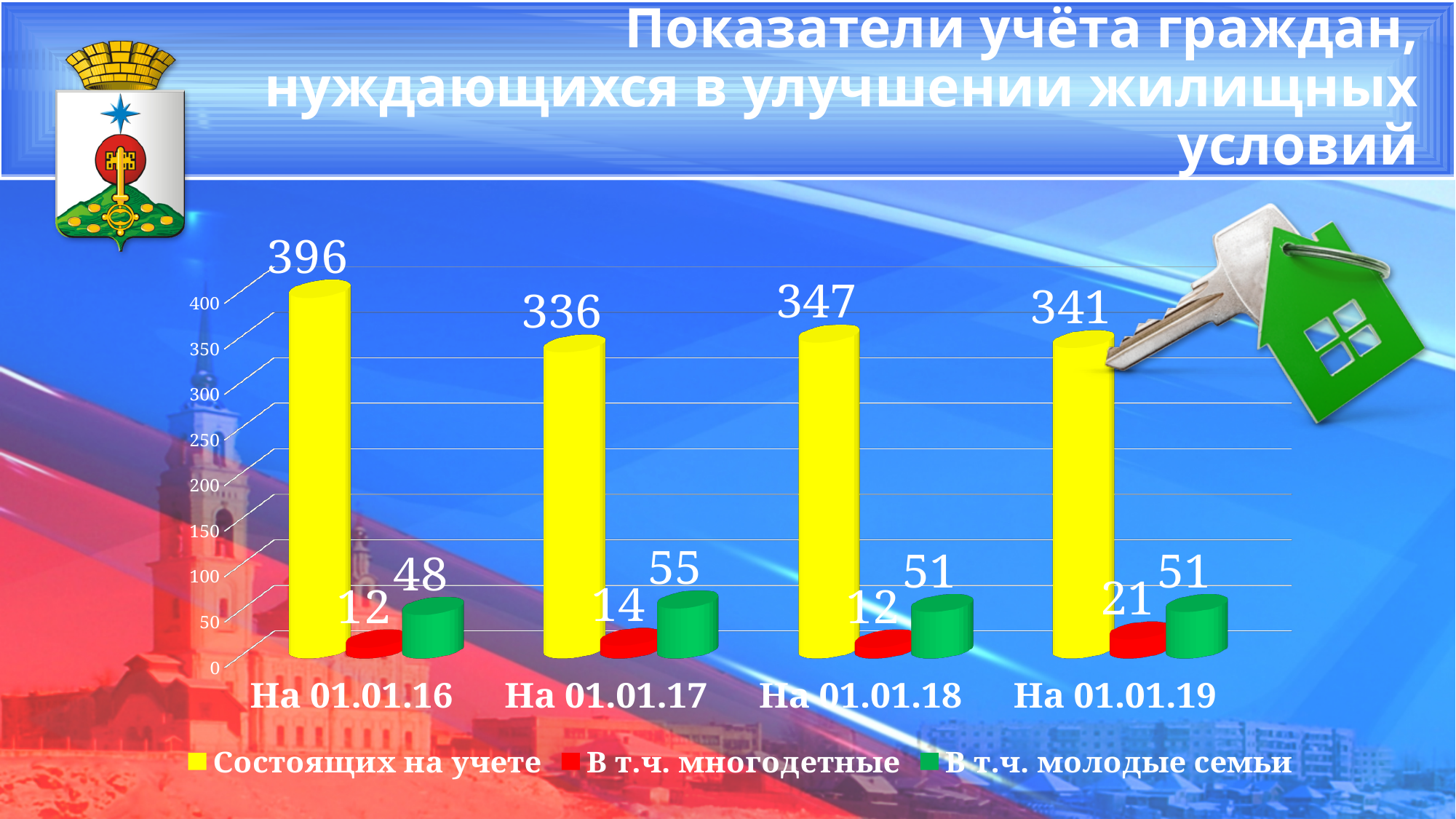
What is the difference between "Состоящих на учете" for "На 01.01.16" and "На 01.01.17"? 60 Which colour represents the series "В т.ч. молодые семьи"? green Which is larger: "В т.ч. многодетные" for "На 01.01.17" or for "На 01.01.19"? На 01.01.19 Which category has the lowest value for "Состоящих на учете"? На 01.01.17 What is the value of "В т.ч. молодые семьи" for "На 01.01.17"? 55 What is the value of "В т.ч. многодетные" for "На 01.01.19"? 21 What is the value of "Состоящих на учете" for "На 01.01.16"? 396 Is the value of "Состоящих на учете" for "На 01.01.18" greater or less than 300? greater How many categories are shown on the x axis? 4 Which category has the highest value for "Состоящих на учете"? На 01.01.16 How many series does the legend list? 3 What kind of chart is shown on the slide? bar chart